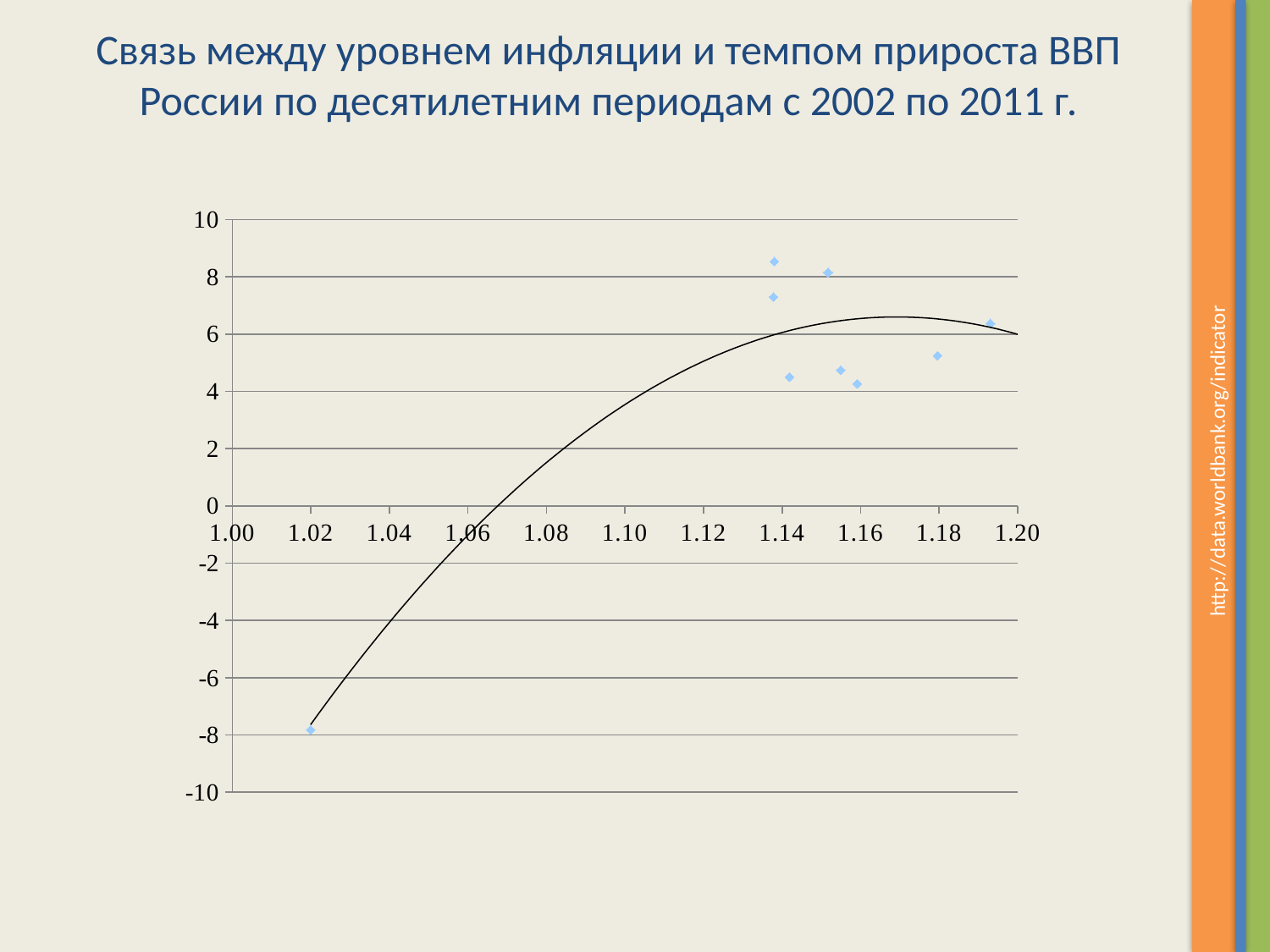
Does the fitted curve rise or fall as x increases from 1.18 to 1.20? fall What is the title of the chart? Связь между уровнем инфляции и темпом прироста ВВП России по десятилетним периодам с 2002 по 2011 г. Is the value of the data point near x = 1.18 greater or less than 4? greater Is the value of the highest data point greater or less than 8? greater What kind of chart is shown on the slide? scatter chart What is the highest value shown on the vertical axis? 10 Is the value of the lowest data point greater or less than -6? less Which is larger: the value of the data point near x = 1.02 or the value of the data point near x = 1.19? the point near x = 1.19 Does the fitted curve rise or fall as x increases from 1.02 to 1.14? rise